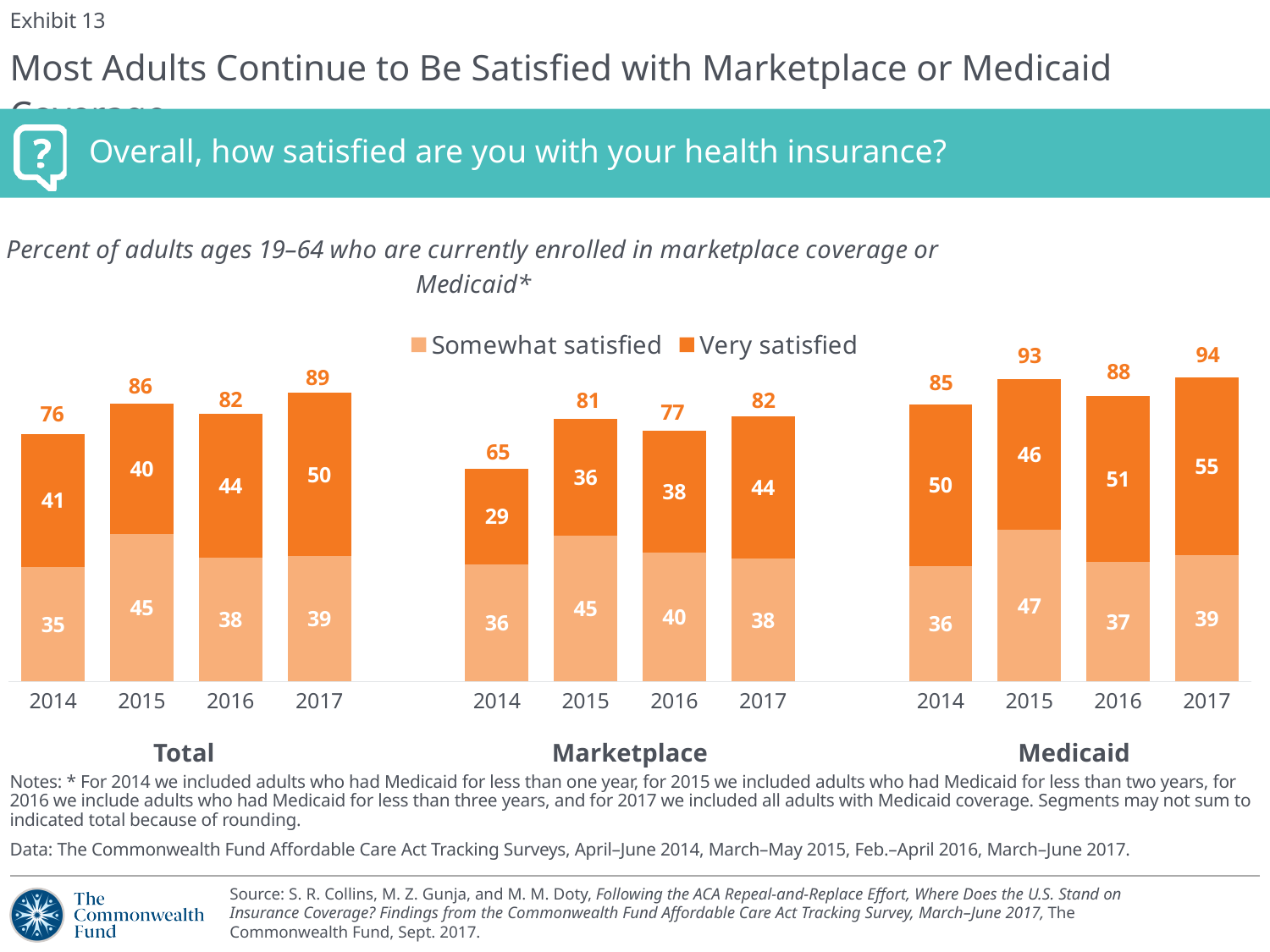
Which year has the lowest total satisfied percentage in the Marketplace group? 2014 What is the 'Somewhat satisfied' value for Marketplace in 2015? 45 What is the total satisfied percentage shown above the Total bar for 2014? 76 What is the difference between the 'Very satisfied' values for Medicaid in 2017 and Marketplace in 2017? 11 What is the 'Very satisfied' value for Medicaid in 2017? 55 What are the three group labels shown beneath the chart? Total, Marketplace, Medicaid Which is larger: the 'Very satisfied' value for Total in 2016 or for Marketplace in 2016? Total in 2016 Does the total satisfied percentage for Medicaid rise or fall from 2014 to 2015? Rise What kind of chart is shown on the slide? Stacked bar chart Which year has the highest total satisfied percentage in the Medicaid group? 2017 How many bars are shown in the Medicaid group? 4 How many series does the legend list? 2